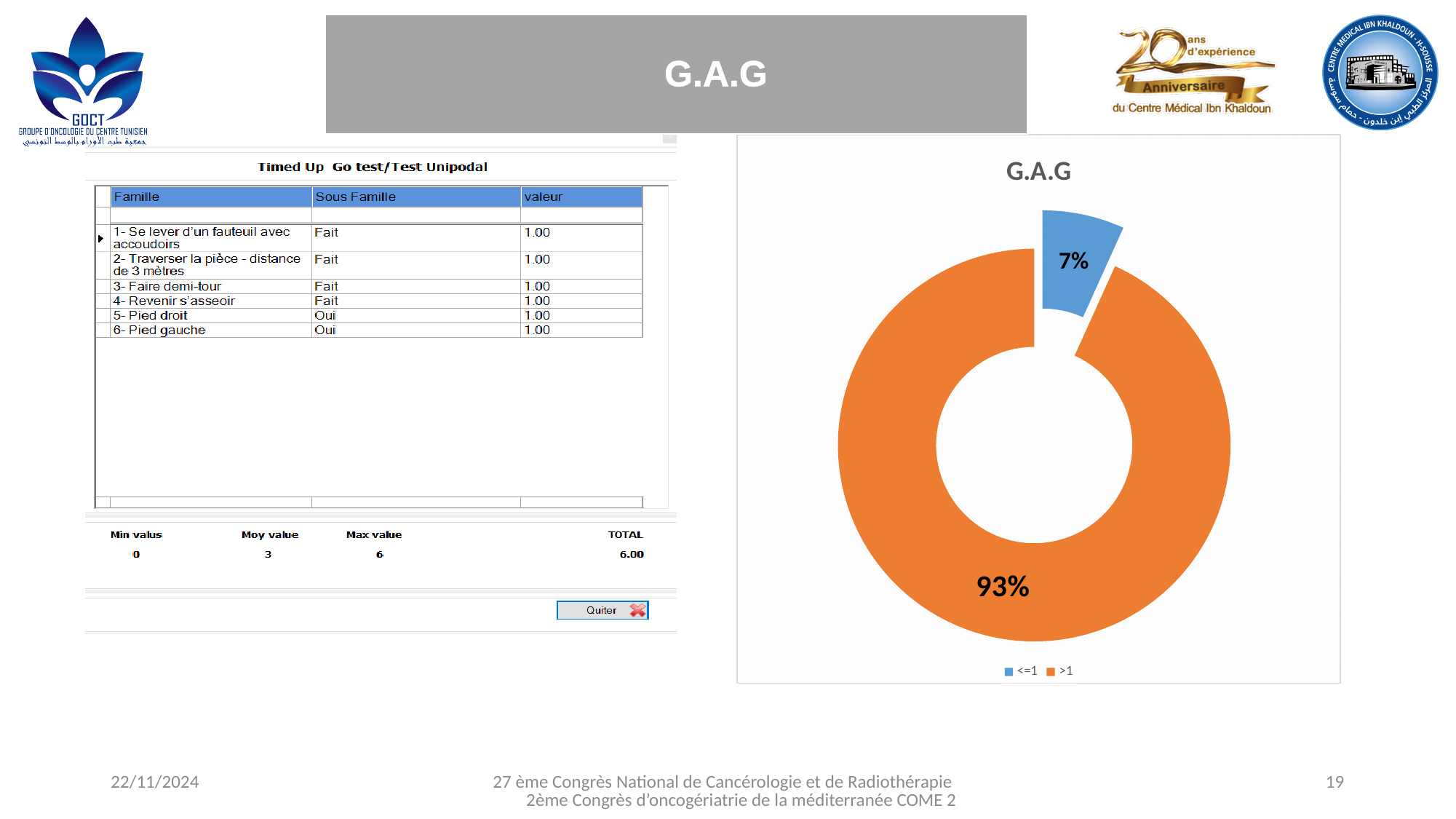
In the G.A.G chart, what percentage is shown for the ">1" category? 93% In the G.A.G chart, which category has the largest share? >1 In the G.A.G chart, what is the difference in percentage points between the ">1" and "<=1" shares? 86 In the G.A.G chart, what share of the doughnut does the orange slice represent? 93% What kind of chart is the G.A.G chart? doughnut chart In the G.A.G chart, which is larger: the share for "<=1" or the share for ">1"? >1 In the G.A.G chart, which category has the smallest share? <=1 What is the title of the chart on the right side of the slide? G.A.G How many categories does the legend of the G.A.G chart list? 2 In the G.A.G chart, what percentage is shown for the "<=1" category? 7% In the G.A.G chart, what colour is the "<=1" slice? blue